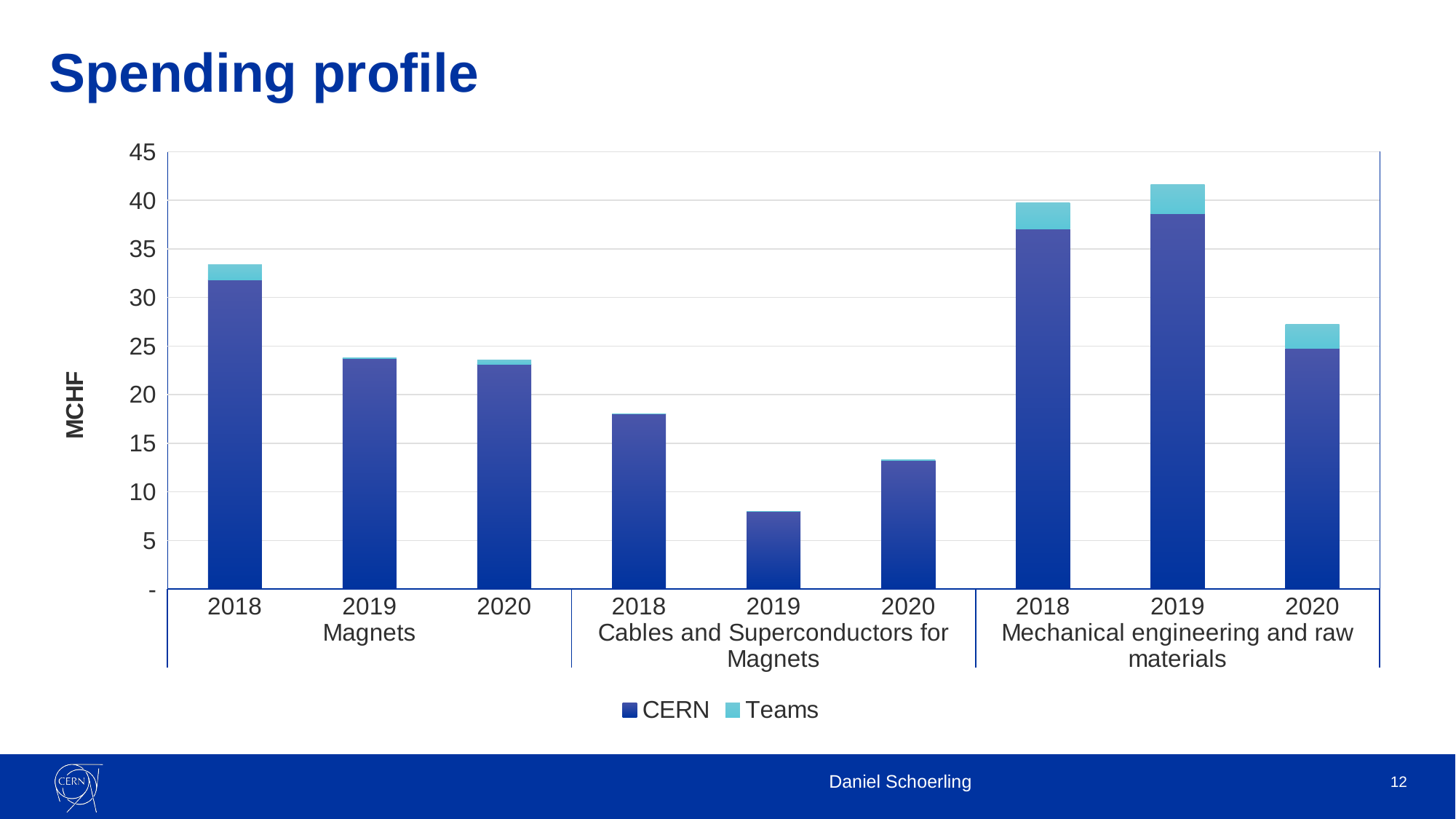
Is the total for 2018 under Magnets greater or less than 30? greater What is the label on the vertical axis? MCHF Is the total for 2019 under Cables and Superconductors for Magnets greater or less than 10? less What kind of chart is shown on the slide? bar chart Is the total for 2018 under Cables and Superconductors for Magnets greater or less than 15? greater Which bar has the highest total spending? 2019 Mechanical engineering and raw materials How many bars are plotted in the chart? 9 Which is larger for Magnets: the total for 2018 or the total for 2019? 2018 How many series does the legend list? 2 Which bar has the lowest total spending? 2019 Cables and Superconductors for Magnets Does the total for Magnets rise or fall from 2018 to 2019? fall